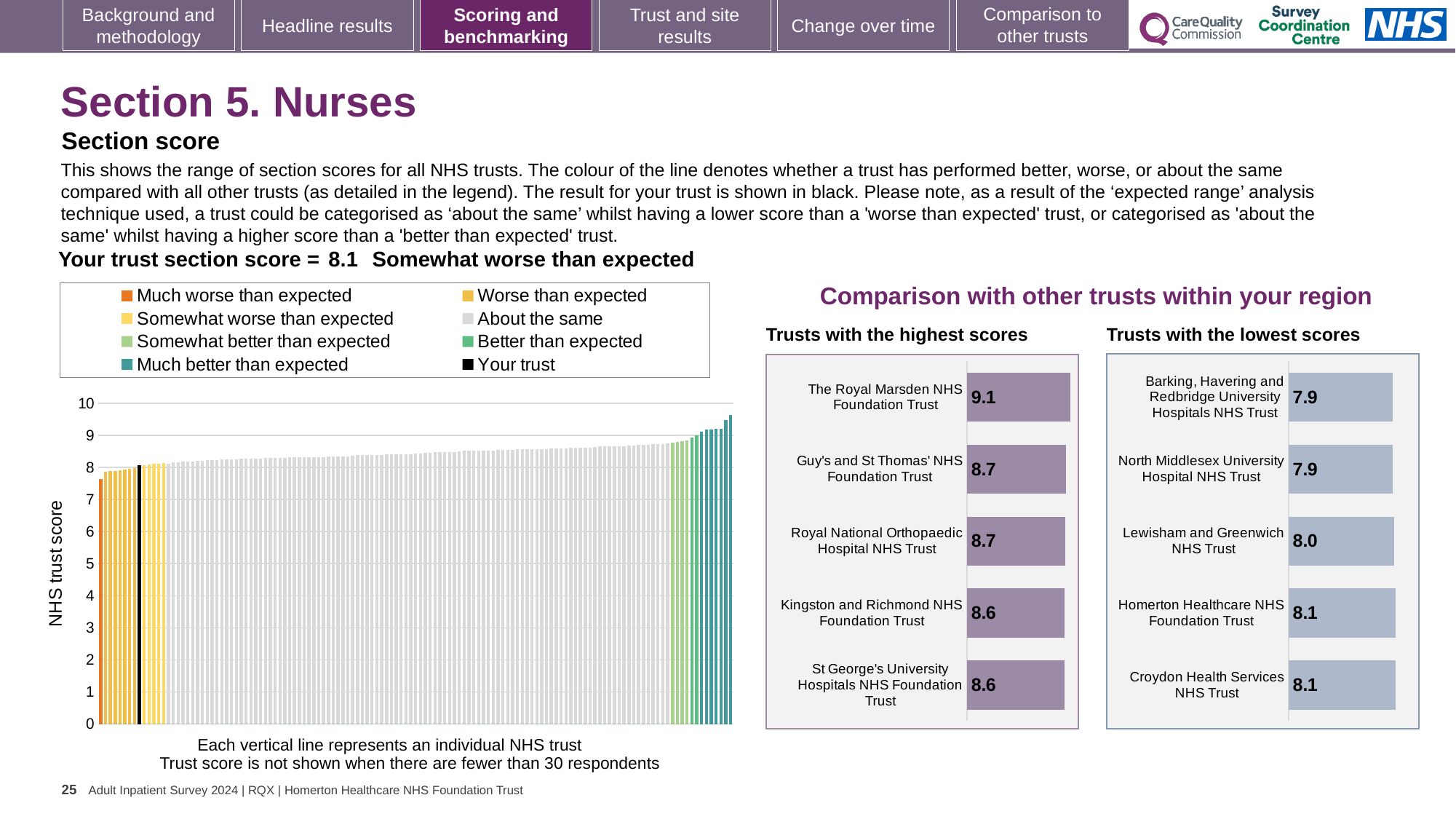
In the 'Trusts with the highest scores' chart, which has the larger score: Guy's and St Thomas' NHS Foundation Trust or St George's University Hospitals NHS Foundation Trust? Guy's and St Thomas' NHS Foundation Trust In the 'Trusts with the highest scores' chart, what is the score for The Royal Marsden NHS Foundation Trust? 9.1 In the main NHS trust score chart legend, what colour represents 'Your trust'? black In the 'Trusts with the lowest scores' chart, what is the difference between the scores of Croydon Health Services NHS Trust and Barking, Havering and Redbridge University Hospitals NHS Trust? 0.2 What kind of chart is the 'Trusts with the highest scores' chart? bar chart In the 'Trusts with the highest scores' chart, which trust has the highest score? The Royal Marsden NHS Foundation Trust In the 'Trusts with the lowest scores' chart, what is the score for Lewisham and Greenwich NHS Trust? 8.0 According to the slide, what is your trust's section score for Section 5. Nurses? 8.1 In the 'Trusts with the highest scores' chart, what is the difference between the scores of The Royal Marsden NHS Foundation Trust and Kingston and Richmond NHS Foundation Trust? 0.5 In the main NHS trust score chart, is the value of the tallest bar on the far right greater or less than 9? greater In the main NHS trust score chart, do the bar values rise or fall from left to right? rise How many trusts are shown in the 'Trusts with the lowest scores' chart? 5